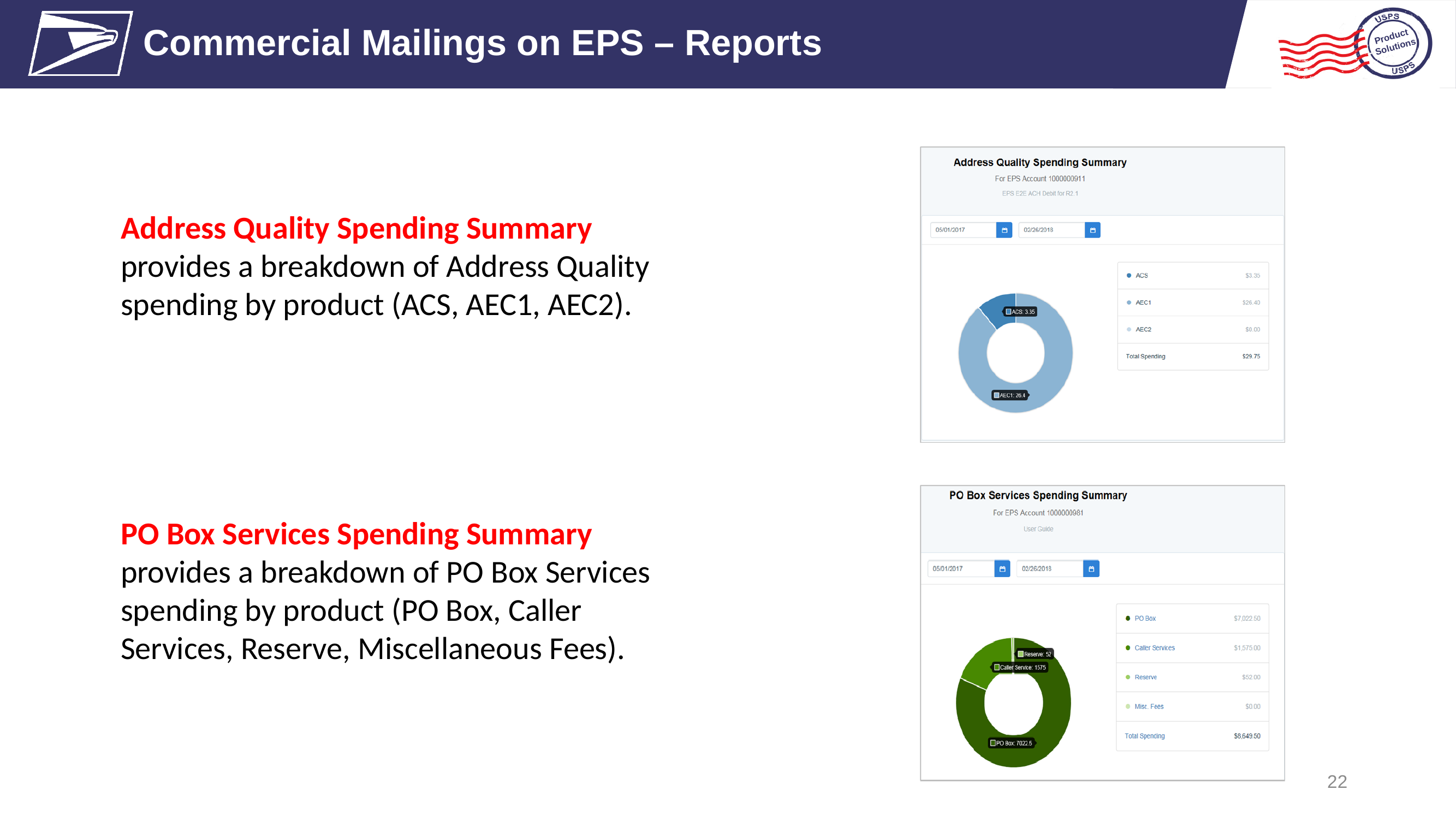
In the PO Box Services Spending Summary, is the spending for PO Box or Caller Services larger? PO Box In the Address Quality Spending Summary, what is the spending for ACS? $3.35 In the PO Box Services Spending Summary, what is the spending for PO Box? $7,022.50 In the PO Box Services Spending Summary, what is the spending for Reserve? $52.00 In the Address Quality Spending Summary, what is the Total Spending shown? $29.75 In the Address Quality Spending Summary, which product has the highest spending? AEC1 In the PO Box Services Spending Summary, what is the spending for Caller Services? $1,575.00 How many products are listed in the legend of the Address Quality Spending Summary? 3 In the PO Box Services Spending Summary, what is the Total Spending shown? $8,649.50 In the Address Quality Spending Summary, what is the spending for AEC1? $26.40 What type of chart is shown in the Address Quality Spending Summary? Donut (pie) chart In the PO Box Services Spending Summary, which product has the largest share of spending? PO Box